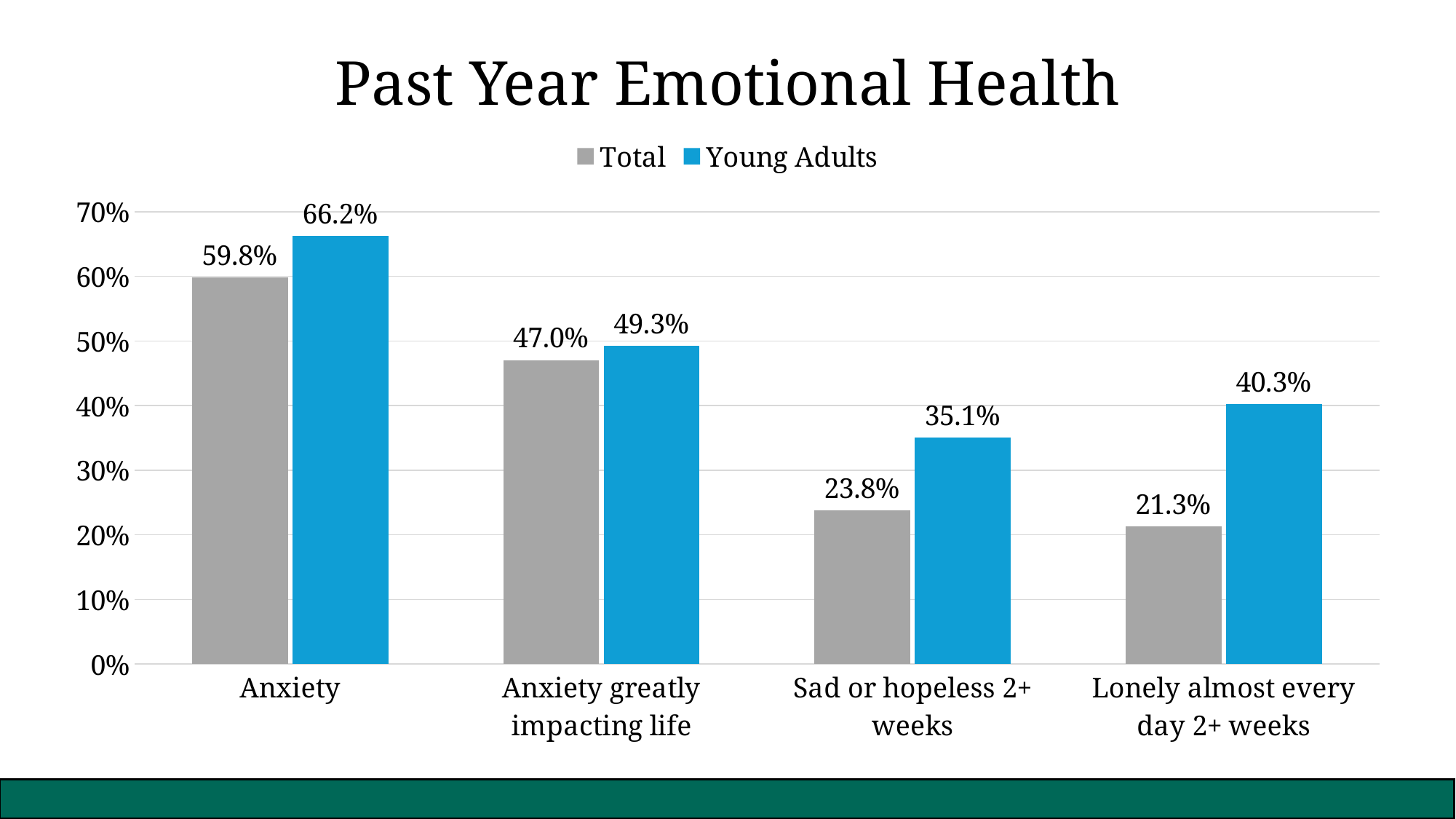
What is the Young Adults value for Anxiety? 66.2% What is the Total value for Lonely almost every day 2+ weeks? 21.3% What is the difference between the Young Adults and Total values for Lonely almost every day 2+ weeks? 19.0% Which category has the lowest Total value? Lonely almost every day 2+ weeks Which category has the highest Young Adults value? Anxiety How many categories are shown on the x axis? 4 Is the Young Adults value for Anxiety greatly impacting life greater or less than 40%? greater What is the Total value for Sad or hopeless 2+ weeks? 23.8% What kind of chart is shown on the slide? Bar chart How many series does the legend list? 2 Which is larger for Sad or hopeless 2+ weeks: the Total value or the Young Adults value? Young Adults What is the title of the chart? Past Year Emotional Health